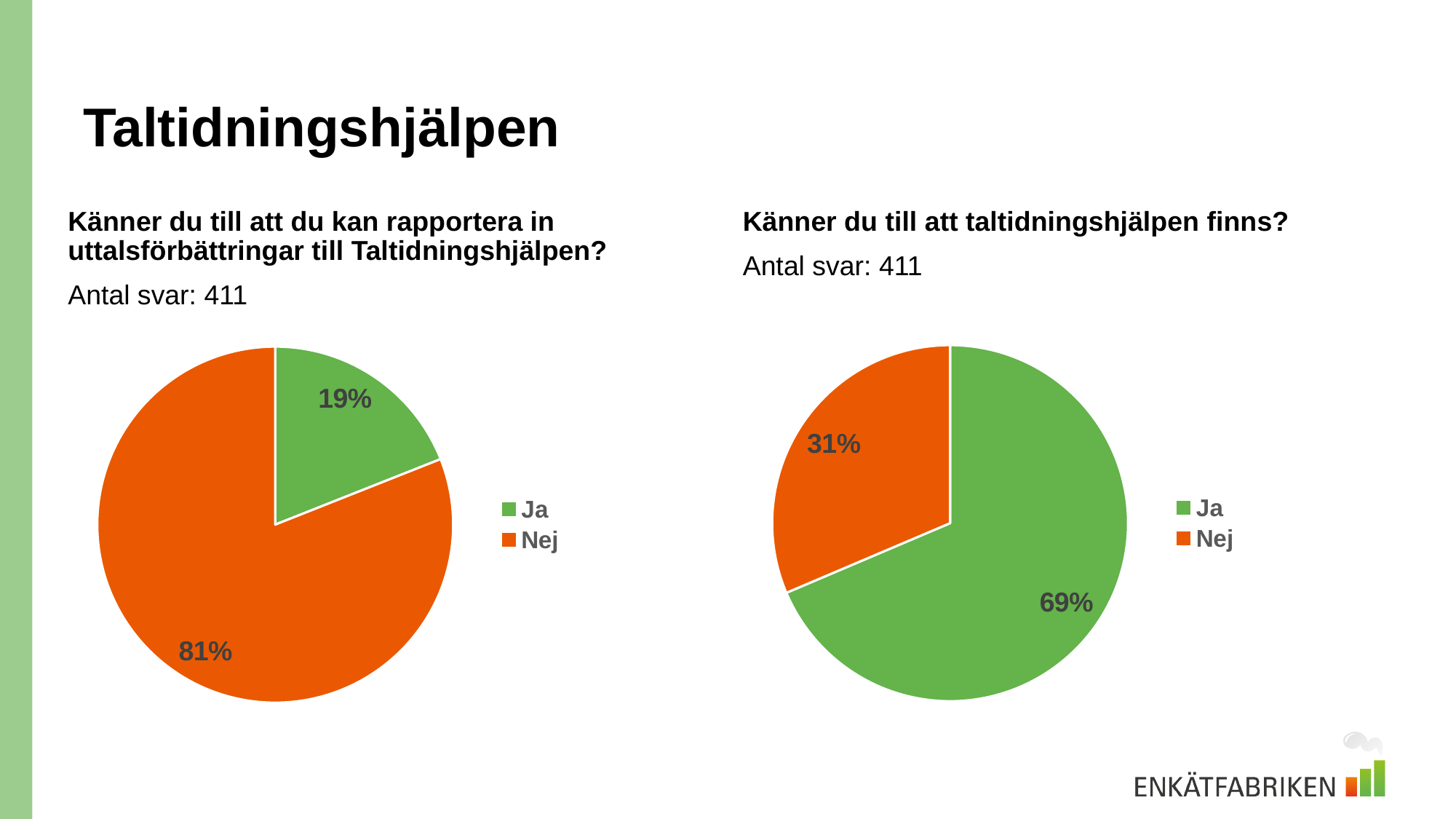
What colour represents Nej in the legends of both pie charts? Orange In the left pie chart ("Känner du till att du kan rapportera in uttalsförbättringar till Taltidningshjälpen?"), what share of respondents answered Nej? 81% In the right pie chart ("Känner du till att taltidningshjälpen finns?"), what share of respondents answered Nej? 31% In the right pie chart, what is the difference in percentage points between Ja and Nej? 38 percentage points In the left pie chart, which answer has the largest slice? Nej In the left pie chart ("Känner du till att du kan rapportera in uttalsförbättringar till Taltidningshjälpen?"), what share of respondents answered Ja? 19% In the right pie chart ("Känner du till att taltidningshjälpen finns?"), what share of respondents answered Ja? 69% What type of chart is used on the left side of the slide? Pie chart In the left pie chart, what is the difference in percentage points between Nej and Ja? 62 percentage points Which is larger: the Ja share in the left pie chart or the Ja share in the right pie chart? The Ja share in the right pie chart How many slices does the right pie chart have? 2 In the right pie chart, which answer has the smallest slice? Nej